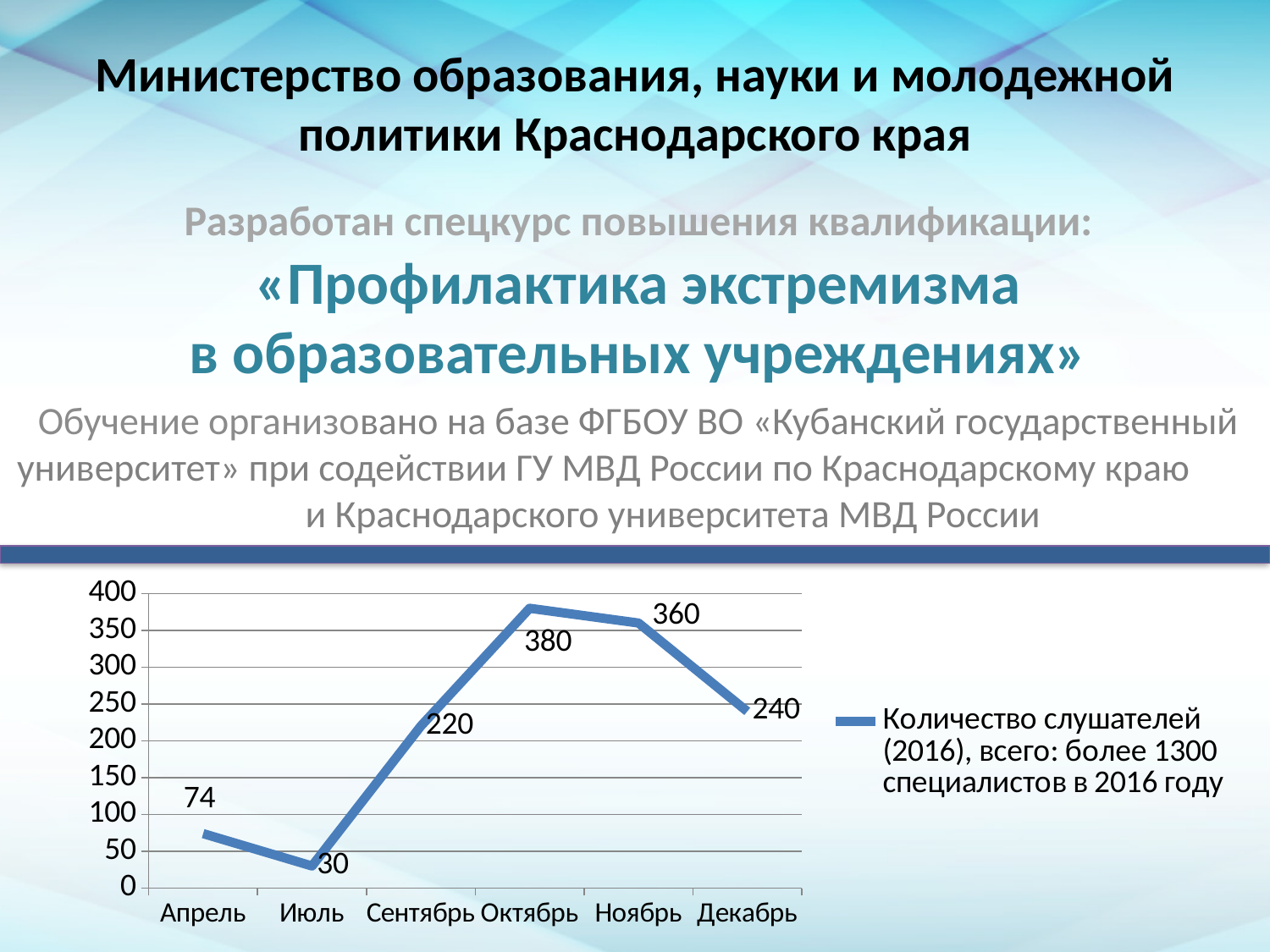
What is the value for Октябрь? 380 What is the value for Апрель? 74 Which is larger, the value for Ноябрь or the value for Декабрь? Ноябрь Which month has the lowest value? Июль How many months are plotted on the x axis? 6 What is the difference between the values for Октябрь and Ноябрь? 20 Does the value rise or fall from Июль to Октябрь? rise What is the value for Декабрь? 240 How many series does the legend list? 1 Which month has the highest value? Октябрь What type of chart is shown on the slide? line chart What is the difference between the values for Сентябрь and Июль? 190